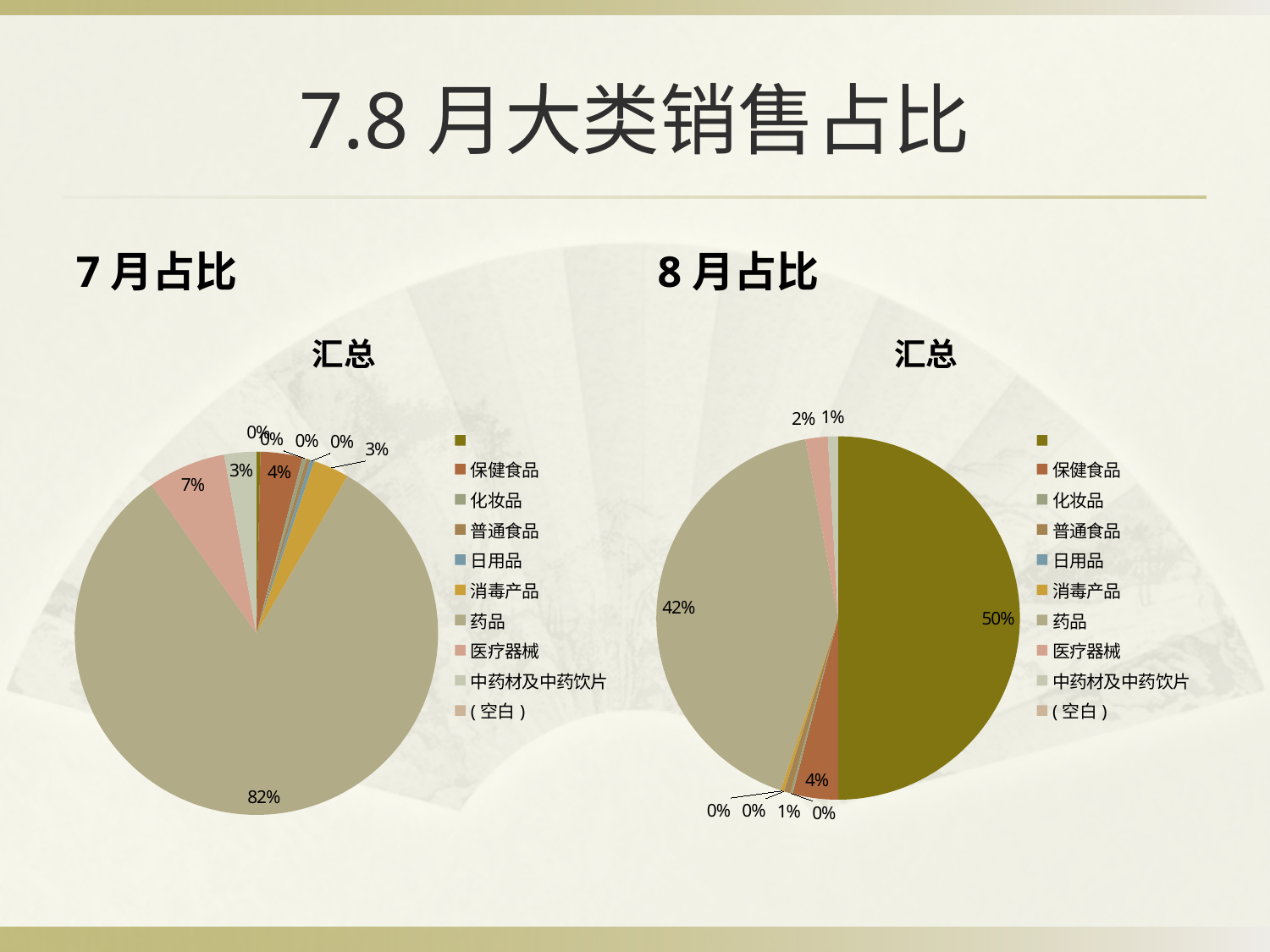
Is the share of 药品 larger in the 7月占比 chart or the 8月占比 chart? 7月占比 By how many percentage points does the 药品 share in the 7月占比 chart exceed the 药品 share in the 8月占比 chart? 40 percentage points In the 8月占比 pie chart, what share does 医疗器械 have? 2% What type of chart is used for the 7月占比 and 8月占比 data? Pie chart In the 7月占比 pie chart, what share does 医疗器械 have? 7% In the 7月占比 pie chart, which category has the largest slice? 药品 In the 8月占比 pie chart, what share does 药品 have? 42% In the 8月占比 pie chart, what is the largest percentage shown on any slice? 50% What title appears above each of the two pie charts? 汇总